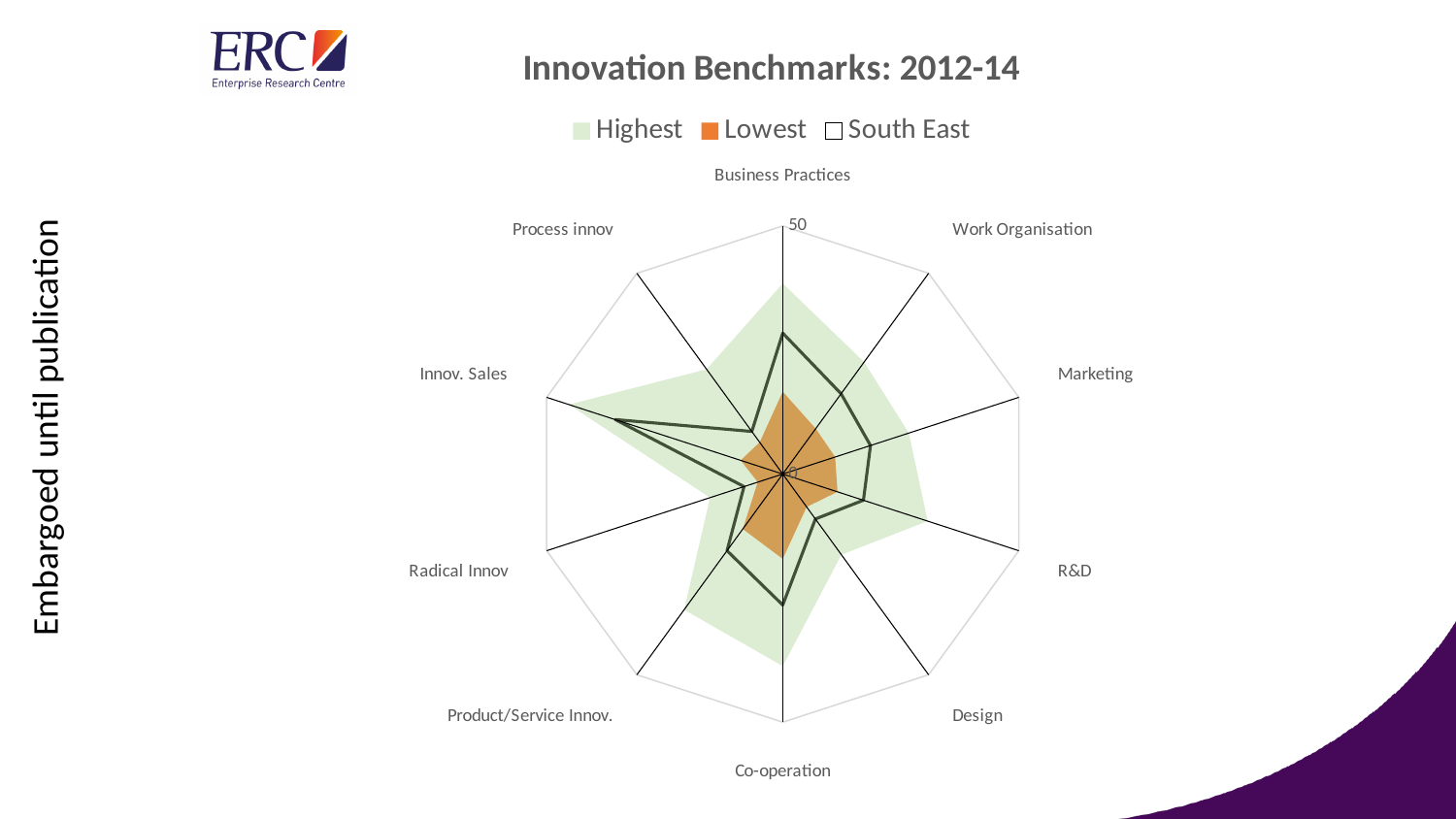
Is the South East value for Co-operation greater or less than 50? less Is the Highest value for Business Practices greater or less than 50? less How many categories (axes) does the radar chart have? 10 What kind of chart is shown on the slide? Radar chart For the South East series, which is larger: Innov. Sales or Radical Innov? Innov. Sales What is the title of the chart? Innovation Benchmarks: 2012-14 What is the maximum value shown on the radar chart's axis scale? 50 Which series is shown in orange in the legend? Lowest For Business Practices, which is larger: the Highest value or the Lowest value? Highest For the South East series, which category has the largest value? Innov. Sales For the Highest series, which category has the largest value? Innov. Sales How many series does the legend list? 3